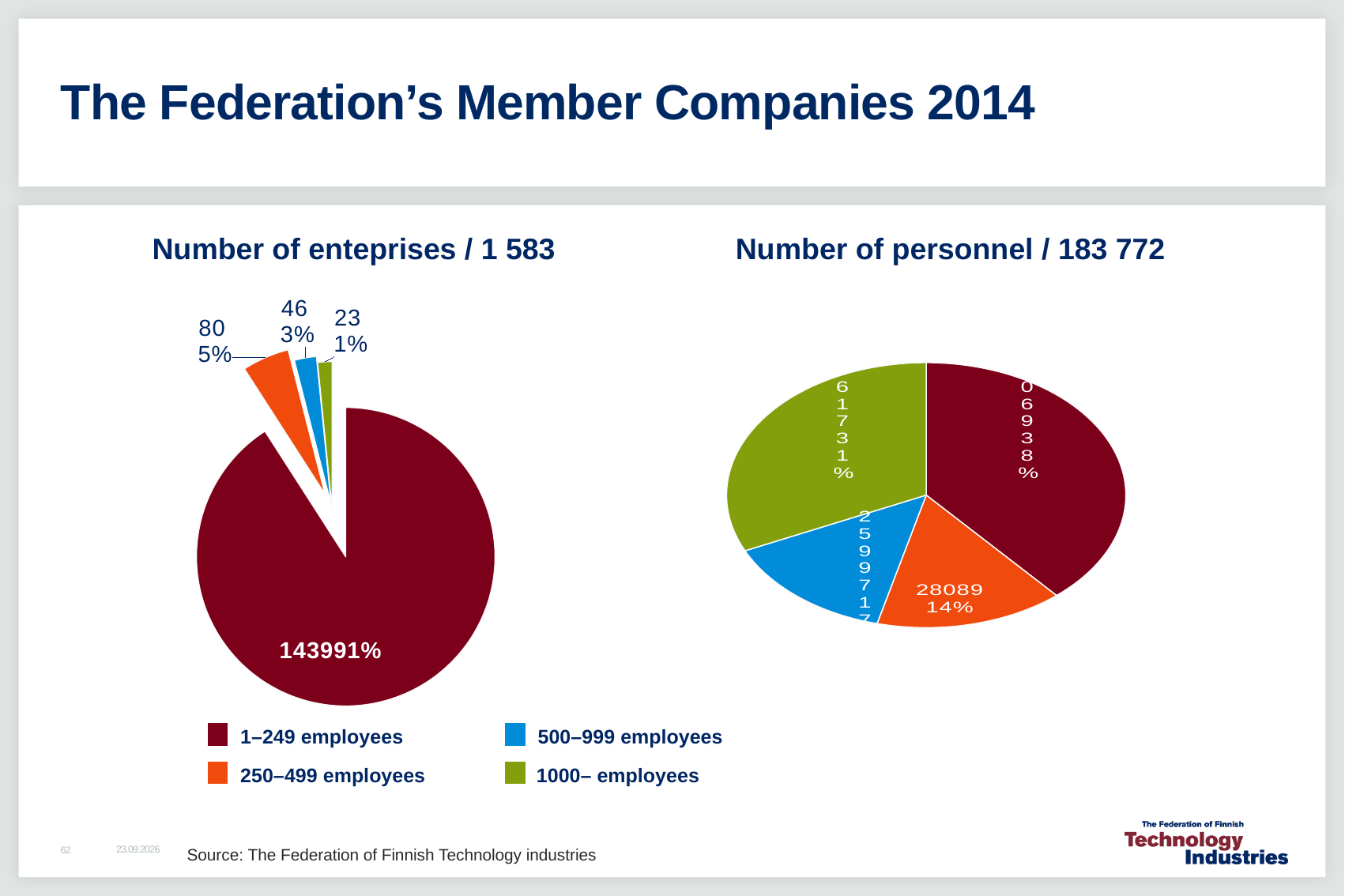
In the 'Number of personnel / 183 772' chart, what share of personnel is in companies with 250–499 employees? 14% In the 'Number of enteprises / 1 583' chart, what share of enterprises have 250–499 employees? 5% In the 'Number of enteprises / 1 583' chart, which has more enterprises: 500–999 employees or 1000– employees? 500–999 employees In the 'Number of enteprises / 1 583' chart, how many enterprises have 250–499 employees? 80 In the 'Number of enteprises / 1 583' chart, which size class has the fewest enterprises? 1000– employees How many size classes does the legend list? 4 In the 'Number of enteprises / 1 583' chart, which size class has the most enterprises? 1–249 employees In the 'Number of enteprises / 1 583' chart, what share of enterprises have 1000– employees? 1% What kind of chart is used for 'Number of enteprises / 1 583'? pie chart In the 'Number of personnel / 183 772' chart, how many personnel are in companies with 250–499 employees? 28089 In the 'Number of enteprises / 1 583' chart, how many enterprises have 500–999 employees? 46 In the 'Number of enteprises / 1 583' chart, how many more enterprises have 250–499 employees than 500–999 employees? 34